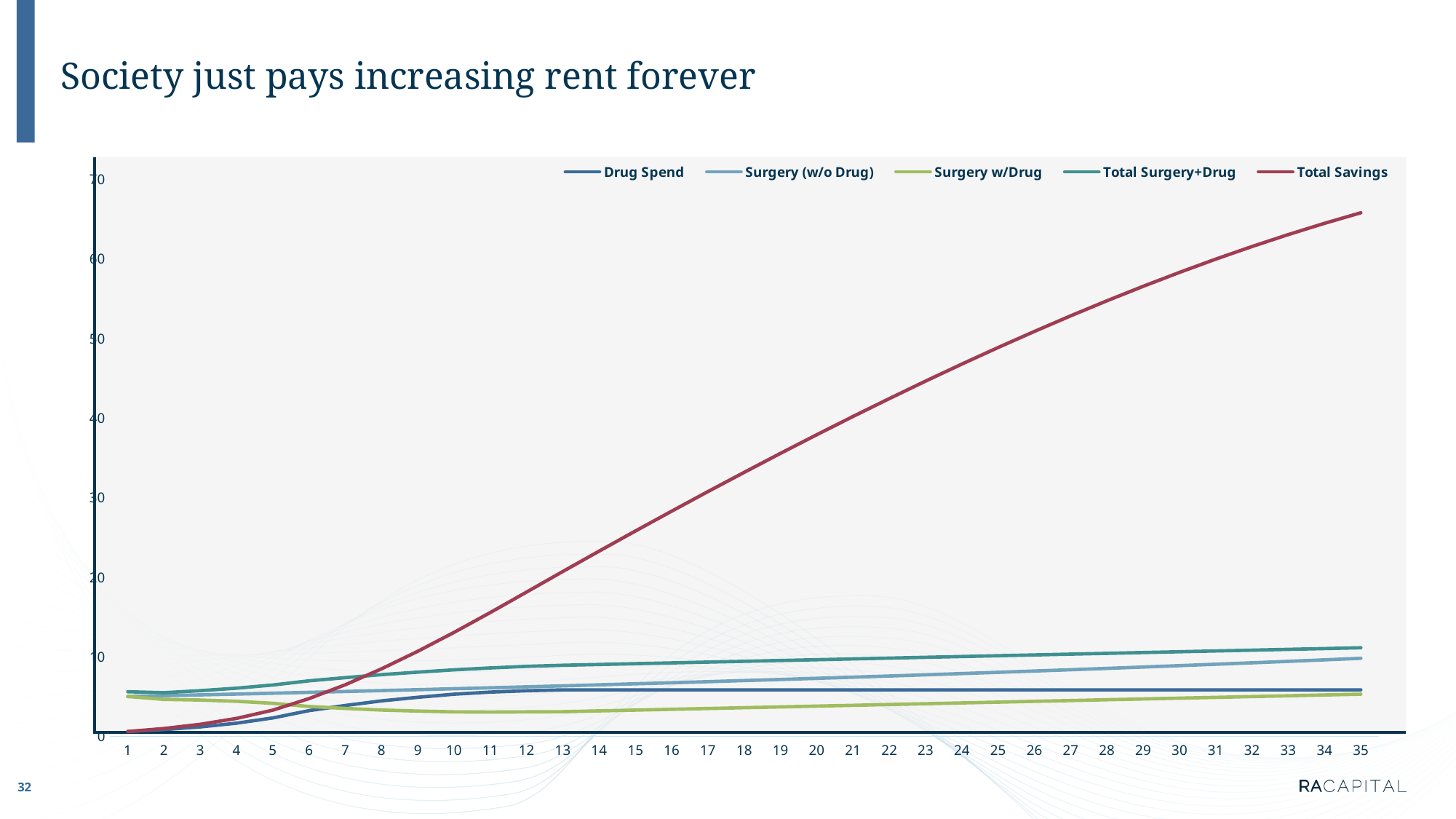
What colour is the Total Savings line in the legend? red What kind of chart is shown on the slide? line chart Is the value of Drug Spend at x = 35 greater or less than 10? less At x = 30, which is larger: Total Savings or Drug Spend? Total Savings Is the value of Total Savings at x = 35 greater or less than 60? greater Which series has the highest value at x = 35? Total Savings Is the value of Total Surgery+Drug at x = 35 greater or less than 20? less How many series does the legend list? 5 How many points are plotted along the x axis for each series? 35 Does the Total Savings line rise or fall as the x axis goes from 1 to 35? rises Which series has the lowest value at x = 20? Surgery w/Drug